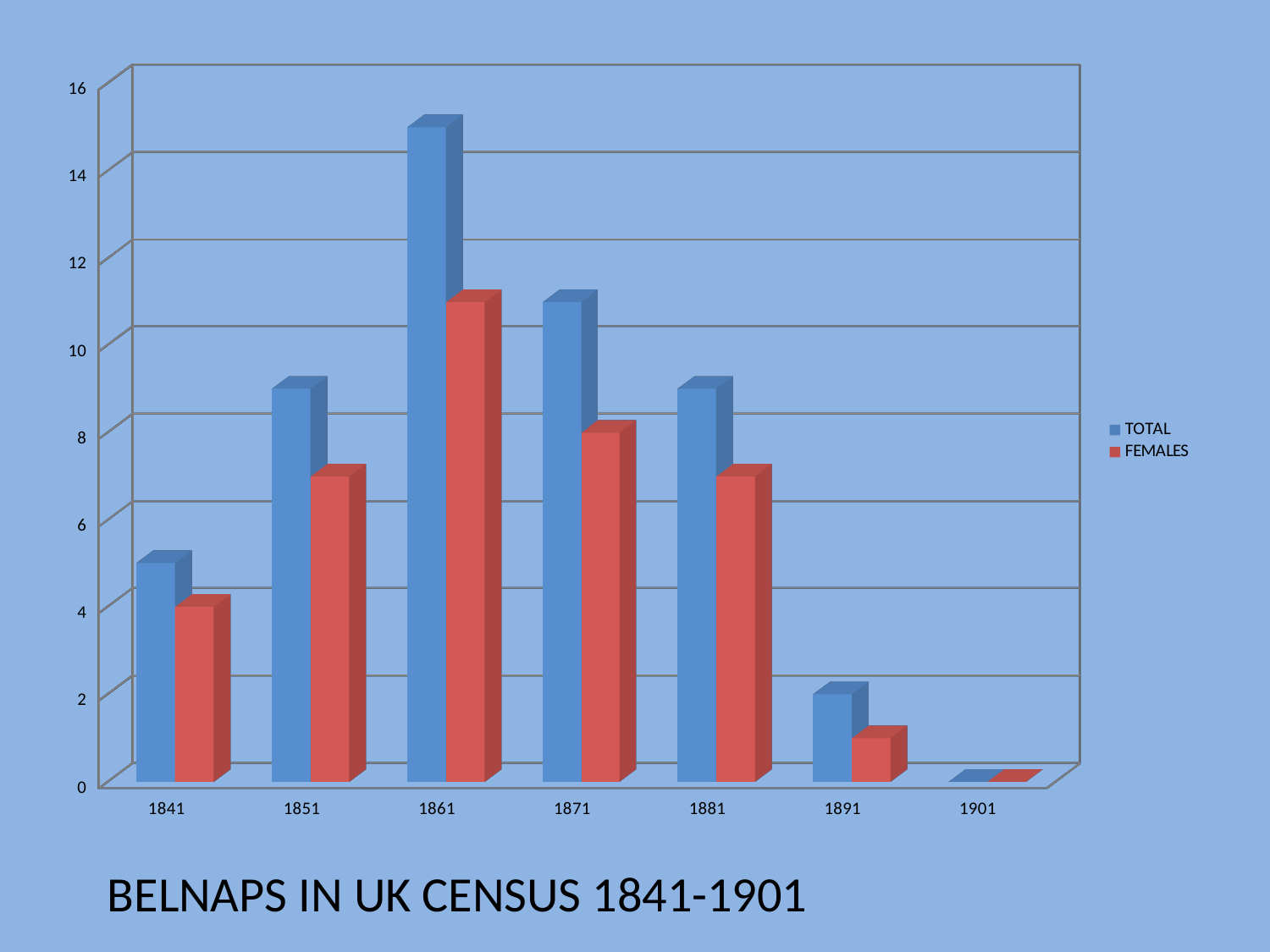
Is the FEMALES value for 1851 greater or less than 8? less Which census year has the highest TOTAL value? 1861 How many census years are shown on the x axis? 7 What is the TOTAL value for 1891? 2 How many series does the legend list? 2 What kind of chart is shown on the slide? bar chart Which census year has the lowest TOTAL value? 1901 What is the FEMALES value for 1841? 4 Is the TOTAL value for 1861 greater or less than 14? greater What is the title of the chart? BELNAPS IN UK CENSUS 1841-1901 What is the TOTAL value for 1901? 0 Which is larger, the TOTAL value for 1871 or the TOTAL value for 1881? 1871